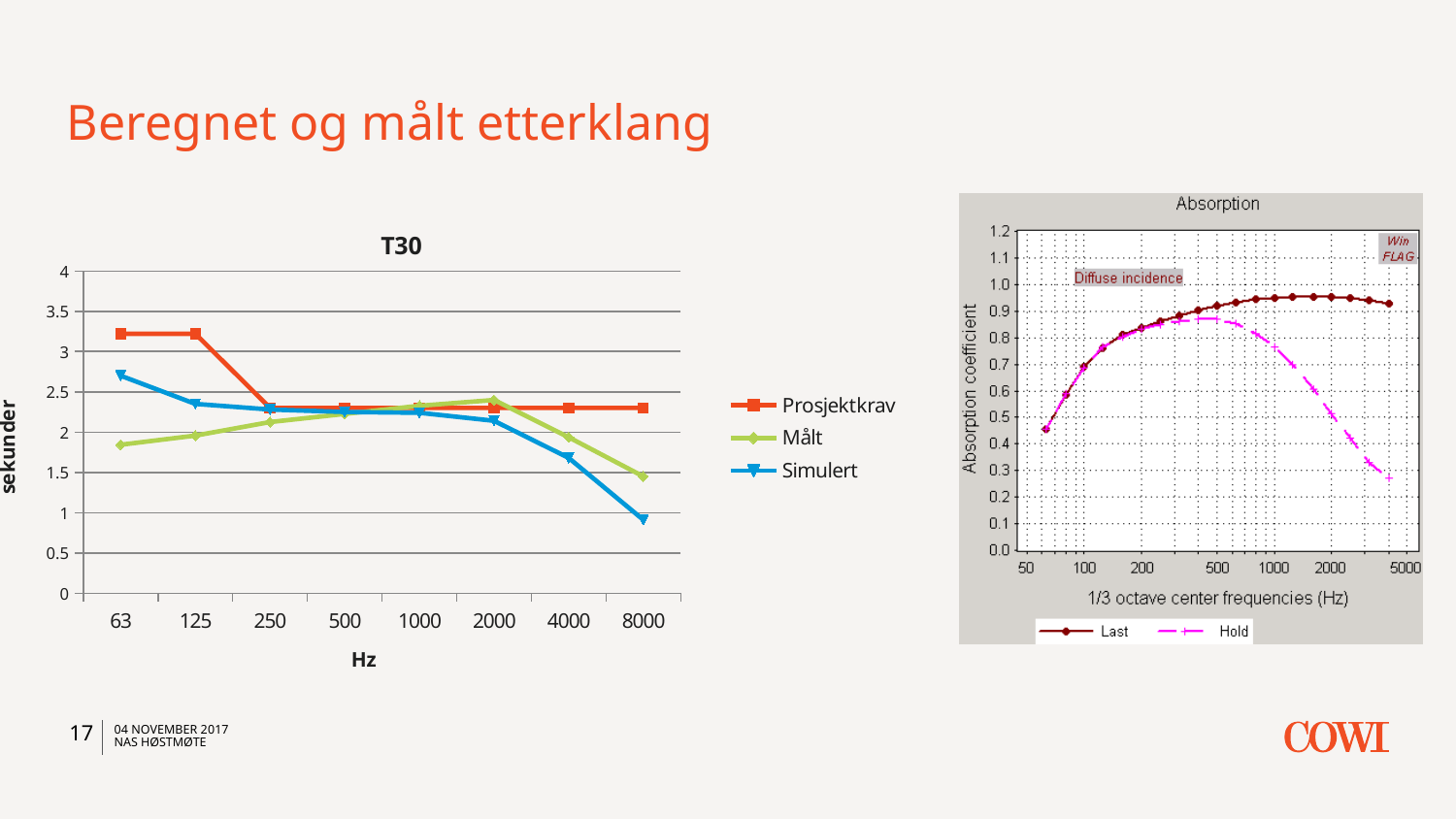
In the Absorption chart, is the Hold value at 4000 Hz greater or less than 0.5? less In the T30 chart, is the Prosjektkrav value at 63 Hz greater or less than 3? greater In the T30 chart, which series has the lowest value at 8000 Hz? Simulert In the T30 chart, which series has the highest value at 63 Hz? Prosjektkrav How many series does the legend of the Absorption chart on the right list? 2 How many frequency categories are shown on the x axis of the T30 chart? 8 In the T30 chart, is the Målt value at 63 Hz greater or less than 2? less In the T30 chart, at 8000 Hz, which is larger: Målt or Simulert? Målt How many series does the legend of the T30 chart list? 3 What kind of chart is the T30 chart on the left? line chart In the T30 chart, does the Simulert series overall rise or fall from 63 Hz to 8000 Hz? fall